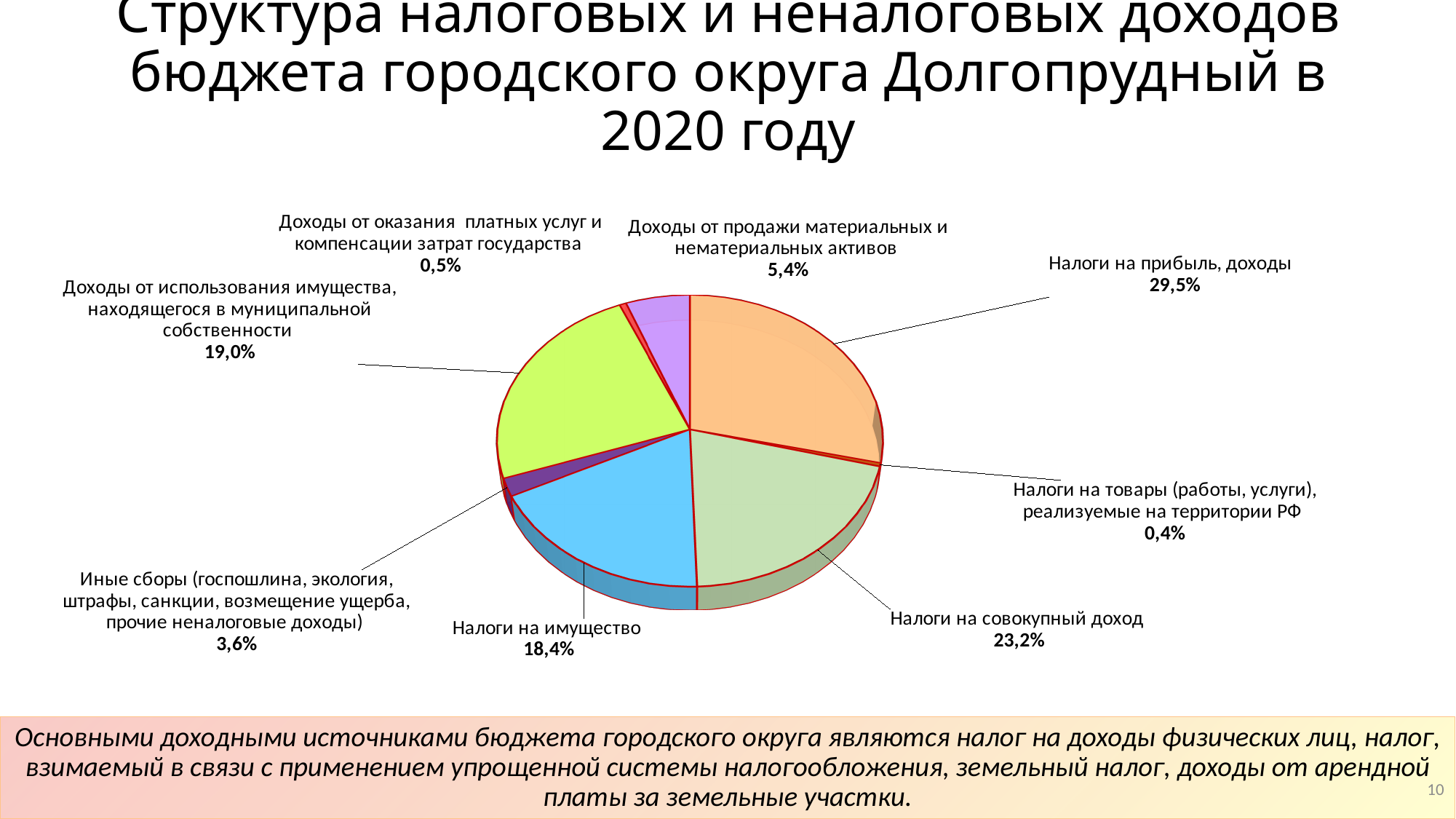
What is the value for «Доходы от продажи материальных и нематериальных активов»? 5,4% What is the difference in percentage points between «Налоги на прибыль, доходы» and «Налоги на совокупный доход»? 6,3 What is the value shown for «Иные сборы (госпошлина, экология, штрафы, санкции, возмещение ущерба, прочие неналоговые доходы)»? 3,6% What kind of chart is shown on the slide? pie chart What is the value shown for «Налоги на совокупный доход»? 23,2% Which category has the largest slice of the pie? Налоги на прибыль, доходы What percentage is shown for «Налоги на имущество»? 18,4% What share is shown for «Доходы от использования имущества, находящегося в муниципальной собственности»? 19,0% Which category has the smallest slice of the pie? Налоги на товары (работы, услуги), реализуемые на территории РФ How many categories (slices) does the pie chart have? 8 Which is larger: «Налоги на имущество» or «Доходы от использования имущества, находящегося в муниципальной собственности»? Доходы от использования имущества, находящегося в муниципальной собственности What share of the budget revenue comes from «Налоги на прибыль, доходы»? 29,5%